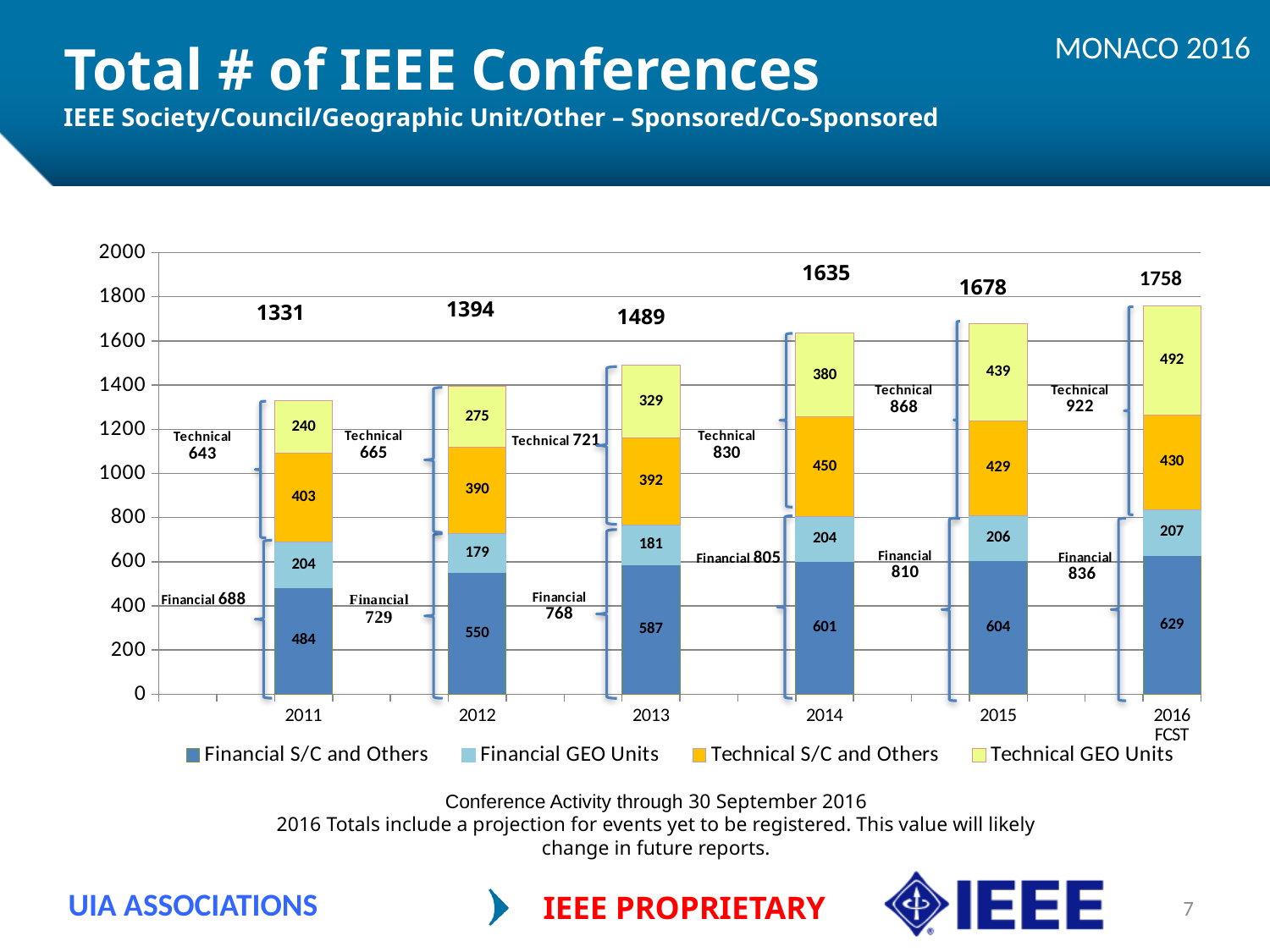
How many years (categories) are shown on the x axis? 6 What is the Technical subtotal labeled for 2015? 868 Which year has the lowest total number of conferences? 2011 Which year has the highest total number of conferences? 2016 FCST What is the difference between the total for 2015 and the total for 2014? 43 What kind of chart is shown on the slide? Stacked bar chart How many series does the legend list? 4 What is the value of Technical GEO Units for 2016 FCST? 492 What is the value of Financial S/C and Others for 2013? 587 Do the total numbers of conferences rise or fall from 2011 to 2016 FCST? Rise What is the total number of IEEE conferences shown for 2014? 1635 Which is larger in 2012: Technical S/C and Others or Financial GEO Units? Technical S/C and Others